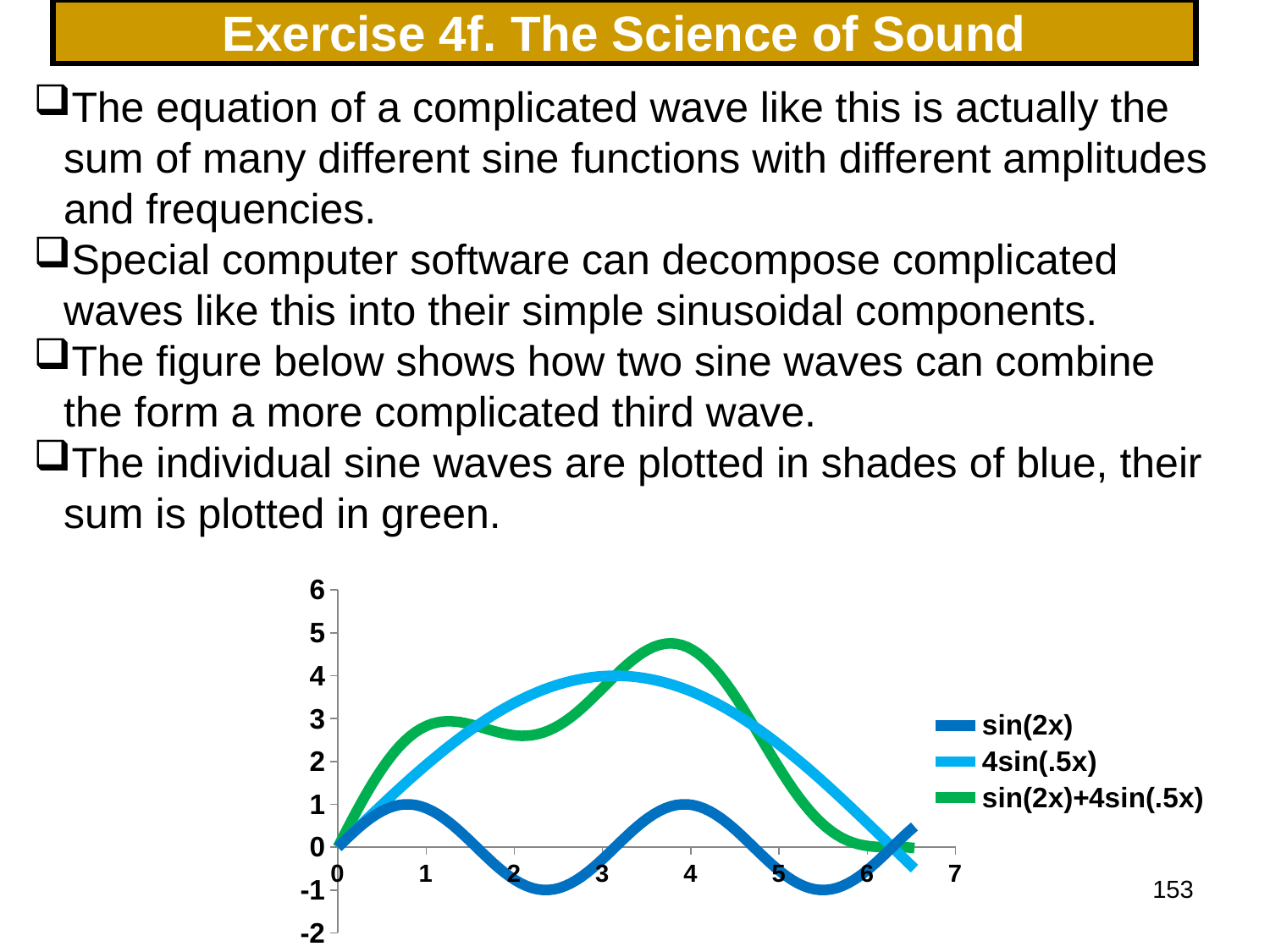
Which series is plotted in green according to the legend? sin(2x)+4sin(.5x) Which series reaches the highest value on the chart? sin(2x)+4sin(.5x) Which reaches a higher peak value, the 4sin(.5x) curve or the sin(2x) curve? 4sin(.5x) What is the highest value labelled on the vertical axis? 6 What is the label of the first series listed in the legend? sin(2x) How many series does the chart's legend list? 3 Does the sin(2x)+4sin(.5x) curve rise or fall between x = 4 and x = 6? fall Is the highest value reached by the sin(2x)+4sin(.5x) curve greater or less than 4? greater Is the lowest value reached by the sin(2x) curve greater or less than 0? less What kind of chart is shown on the slide? line chart Which series reaches the lowest value on the chart? sin(2x) Is the highest value reached by the sin(2x) curve greater or less than 2? less